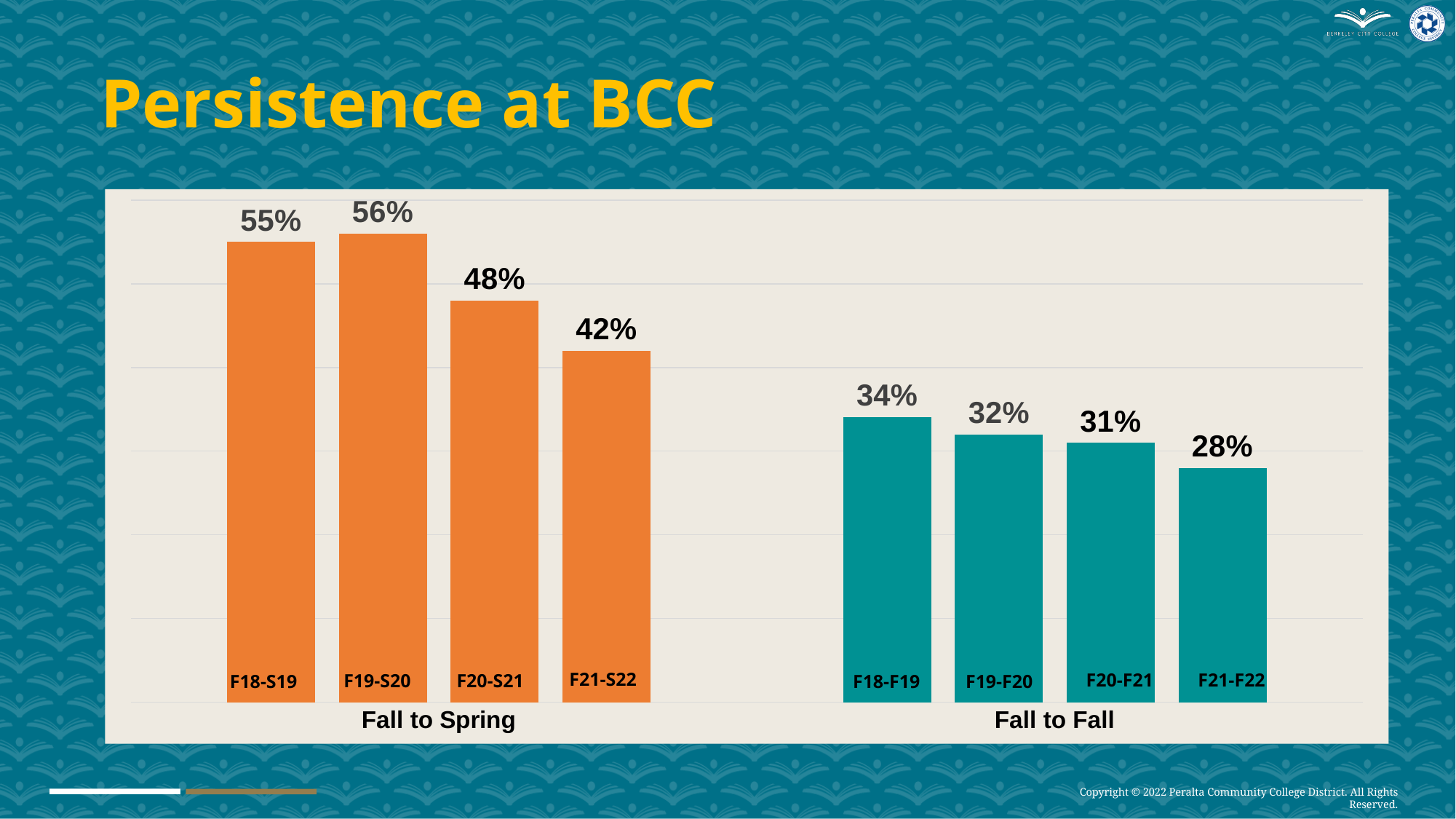
What is the Fall to Fall persistence rate for F21-F22? 28% Which Fall to Spring period has the highest persistence rate? F19-S20 What is the Fall to Spring persistence rate for F18-S19? 55% Which Fall to Fall period has the lowest persistence rate? F21-F22 What is the difference between the Fall to Fall rates for F18-F19 and F21-F22? 6% Do the Fall to Fall persistence rates rise or fall from F18-F19 to F21-F22? Fall What kind of chart is shown on the slide? Bar chart How many bars are shown in the Fall to Fall group? 4 What is the difference between the Fall to Spring rates for F19-S20 and F21-S22? 14% What is the Fall to Spring persistence rate for F20-S21? 48% How many bars are plotted on the chart in total? 8 Which is larger, the Fall to Spring rate for F21-S22 or the Fall to Fall rate for F18-F19? Fall to Spring F21-S22